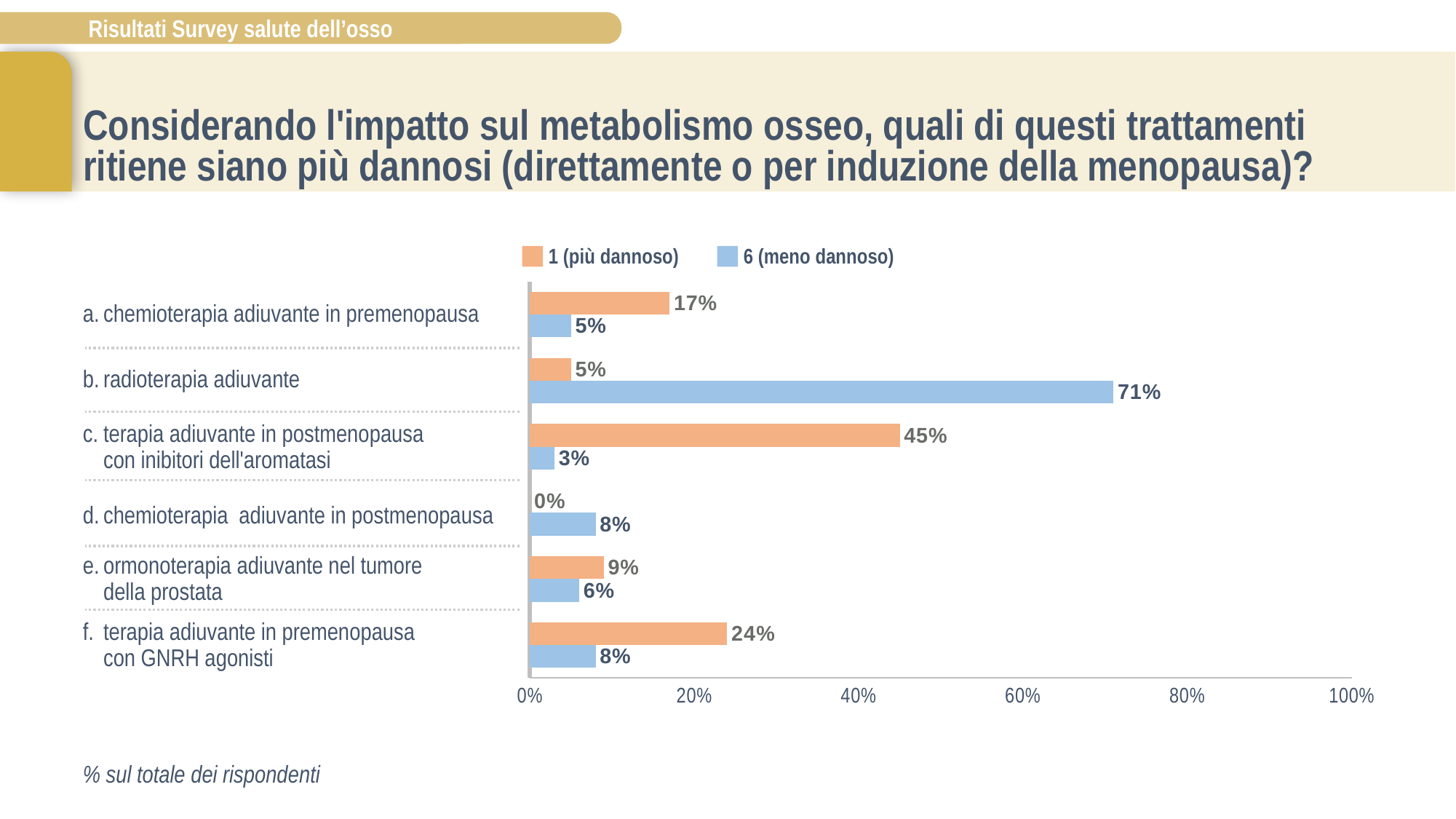
What is the difference between the '1 (più dannoso)' and '6 (meno dannoso)' values for 'f. terapia adiuvante in premenopausa con GNRH agonisti'? 16% What kind of chart is shown on the slide? bar chart How many series does the legend list? 2 For 'a. chemioterapia adiuvante in premenopausa', which is larger: '1 (più dannoso)' or '6 (meno dannoso)'? 1 (più dannoso) What is the value of '1 (più dannoso)' for 'c. terapia adiuvante in postmenopausa con inibitori dell'aromatasi'? 45% Which category has the highest value for '1 (più dannoso)'? c. terapia adiuvante in postmenopausa con inibitori dell'aromatasi What colour represents the '6 (meno dannoso)' series? blue What is the value of '1 (più dannoso)' for 'd. chemioterapia adiuvante in postmenopausa'? 0% Which category has the lowest value for '6 (meno dannoso)'? c. terapia adiuvante in postmenopausa con inibitori dell'aromatasi Is the '6 (meno dannoso)' value for 'b. radioterapia adiuvante' greater or less than 60%? greater How many categories are shown on the chart? 6 What is the value of '6 (meno dannoso)' for 'b. radioterapia adiuvante'? 71%